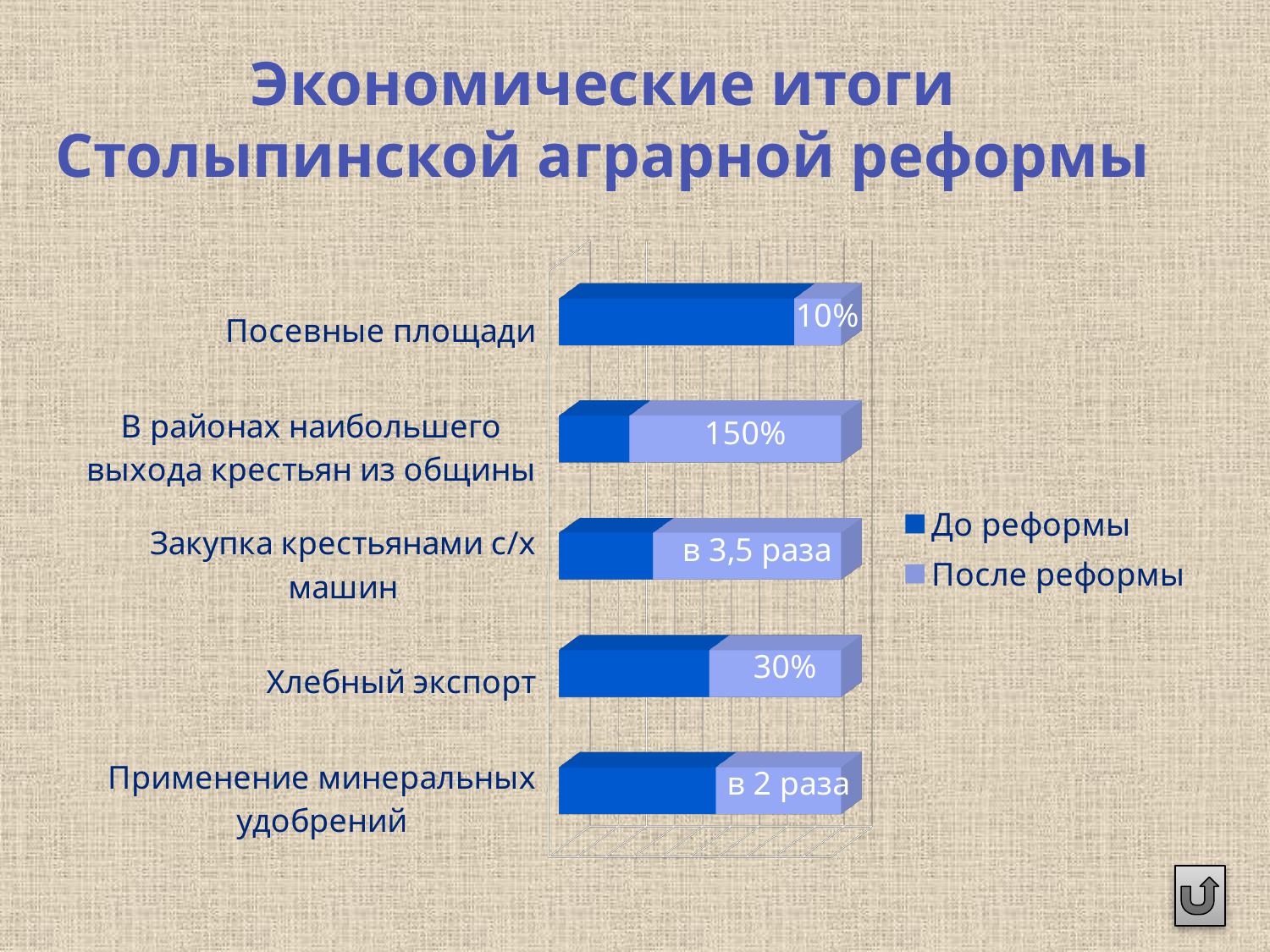
What kind of chart is shown on the slide? bar chart Which category has the longest 'После реформы' segment in the chart? В районах наибольшего выхода крестьян из общины How many categories are plotted in the chart? 5 What data label is shown on the 'После реформы' segment for 'В районах наибольшего выхода крестьян из общины'? 150% What are the two series named in the chart legend? До реформы, После реформы What is the title of the slide containing the chart? Экономические итоги Столыпинской аграрной реформы What data label is shown on the 'После реформы' segment for 'Хлебный экспорт'? 30% What data label is shown on the 'После реформы' segment for 'Посевные площади'? 10% What data label is shown on the 'После реформы' segment for 'Применение минеральных удобрений'? в 2 раза Which category has the shortest 'После реформы' segment in the chart? Посевные площади How many series does the chart legend list? 2 What data label is shown on the 'После реформы' segment for 'Закупка крестьянами с/х машин'? в 3,5 раза